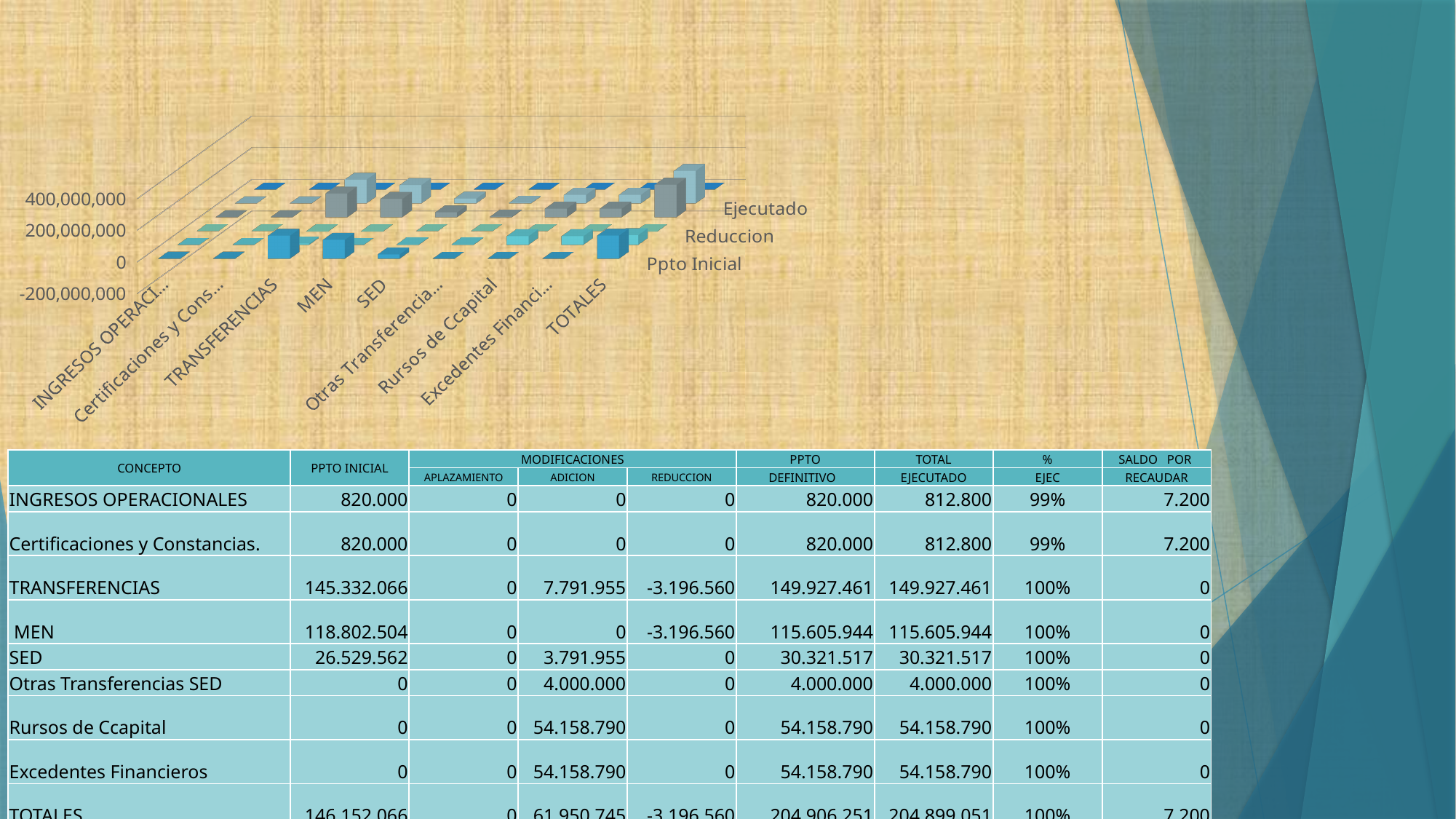
Which has the larger Ejecutado value, MEN or SED? MEN What is the Ejecutado value for SED? 30.321.517 What is the Ppto Inicial value for MEN? 118.802.504 Is the Ejecutado value for Rursos de Ccapital greater or less than 200,000,000? less Which category has the highest Ejecutado value? TOTALES What is the difference between the Ejecutado values for TRANSFERENCIAS and MEN? 34.321.517 Is the Ppto Inicial value for TRANSFERENCIAS greater or less than 200,000,000? less What kind of chart is shown on the slide? bar chart What is the highest value shown on the chart's vertical axis? 400,000,000 What is the Reduccion value for TRANSFERENCIAS? -3.196.560 Which series label is shown nearest the front of the chart's depth axis? Ppto Inicial How many categories are shown along the category axis of the chart? 9